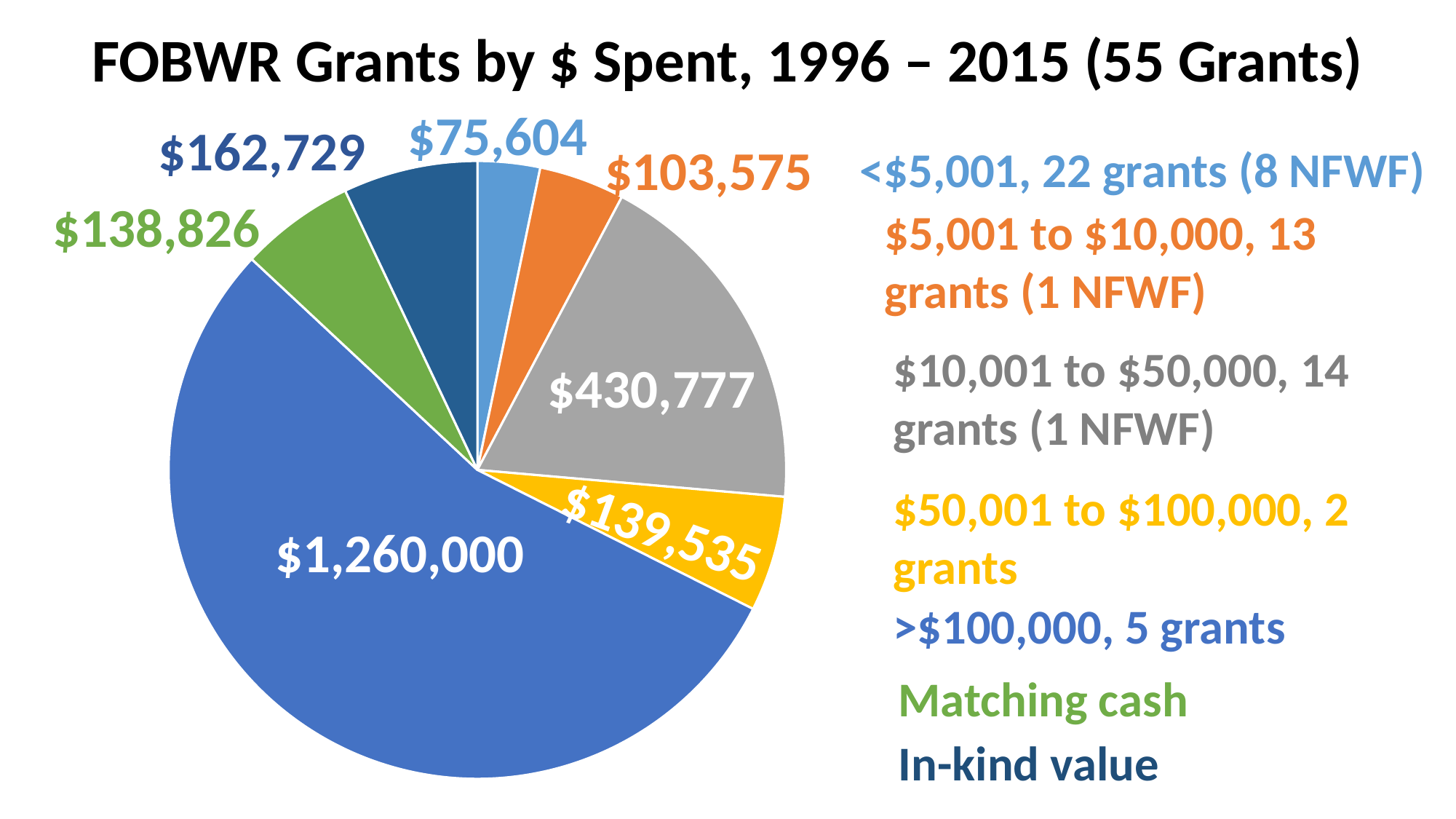
What is the dollar value of the >$100,000 grants slice? $1,260,000 How many slices does the pie chart have? 7 Which is larger: the $10,001 to $50,000 slice or the $50,001 to $100,000 slice? $10,001 to $50,000 ($430,777) Which category has the smallest slice of the pie? <$5,001, 22 grants (8 NFWF) What kind of chart is shown on the slide? Pie chart What is the dollar value of the <$5,001 grants slice? $75,604 What is the dollar value of the Matching cash slice? $138,826 What is the dollar value of the In-kind value slice? $162,729 Which category has the largest slice of the pie? >$100,000, 5 grants What is the difference between the >$100,000 slice and the $10,001 to $50,000 slice? $829,223 What is the title of the chart? FOBWR Grants by $ Spent, 1996 – 2015 (55 Grants) What is the dollar value of the $10,001 to $50,000 grants slice? $430,777